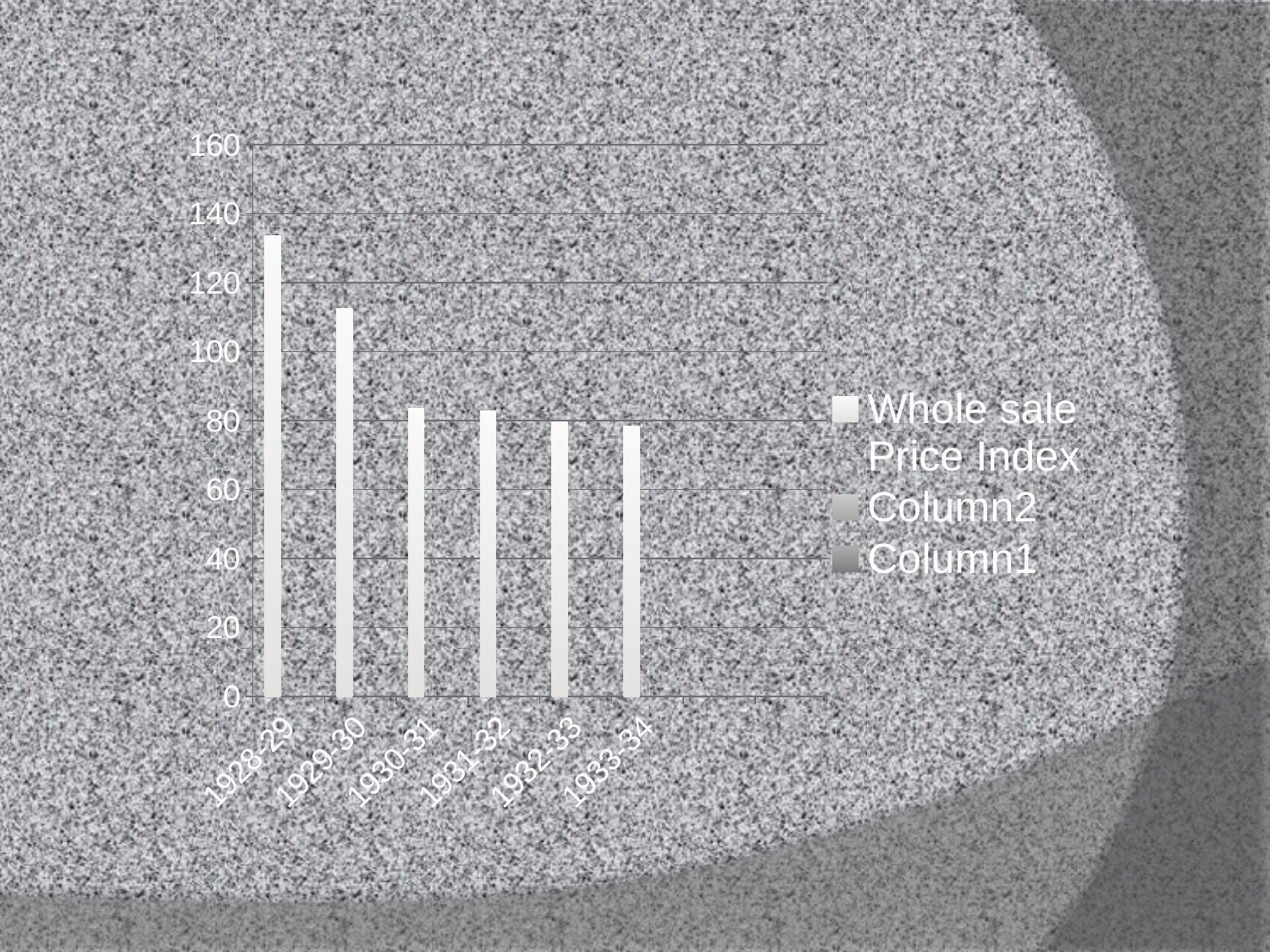
How many categories are shown on the x axis of the chart? 6 Is the value for 1933-34 greater or less than 100? less What is the first entry listed in the chart's legend? Whole sale Price Index Is the value for 1929-30 greater or less than 100? greater Which is larger, the value for 1929-30 or the value for 1930-31? 1929-30 Which category has the highest value in the chart? 1928-29 How many series does the legend list? 3 Do the values rise or fall from 1928-29 to 1933-34? fall Is the value for 1930-31 greater or less than 100? less Which is larger, the value for 1928-29 or the value for 1929-30? 1928-29 What kind of chart is shown on the slide? bar chart